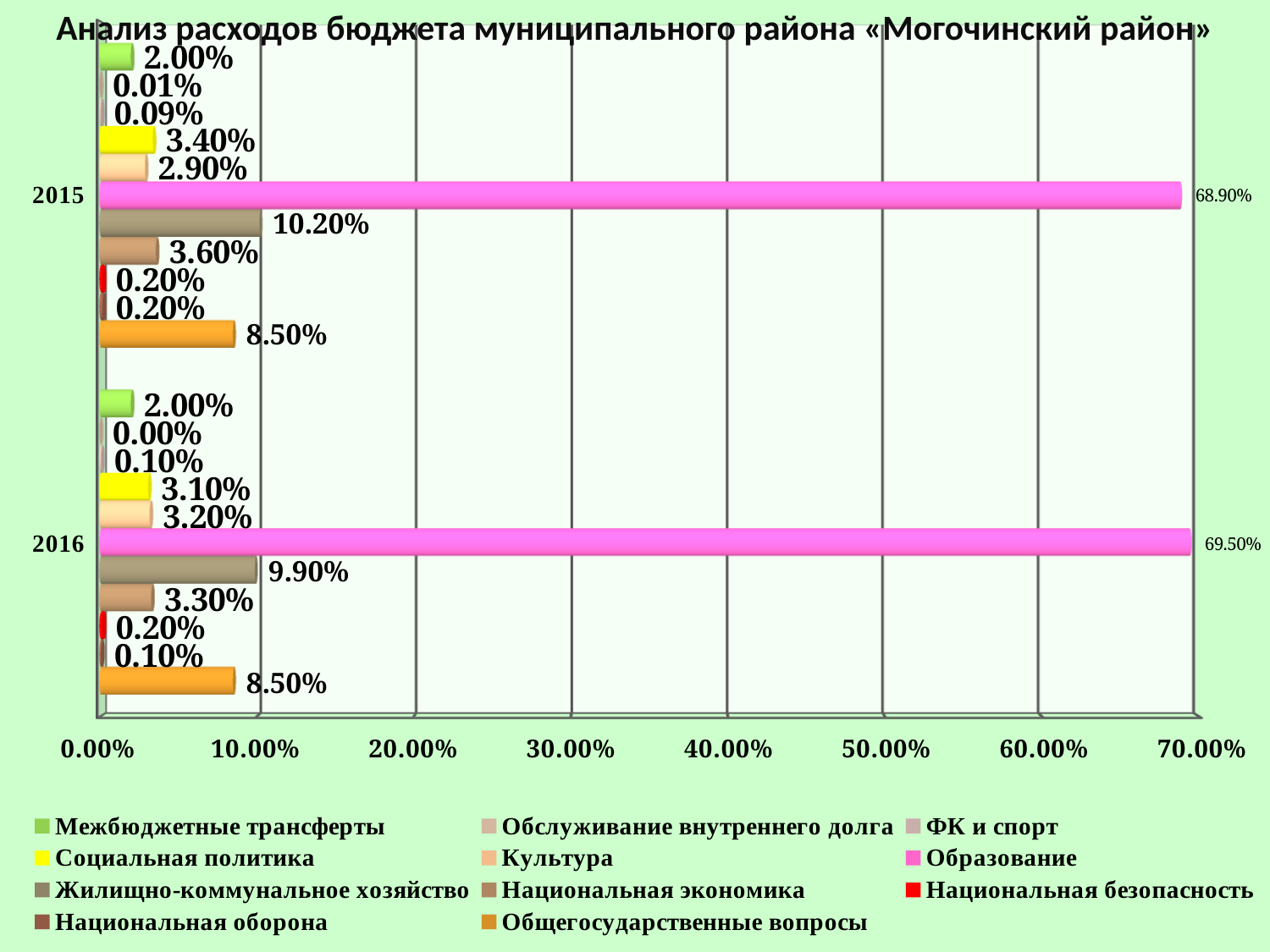
How many series does the legend list? 11 What kind of chart is shown on the slide? bar chart What is the value for Социальная политика in 2016? 3.10% Which is larger in 2015: Жилищно-коммунальное хозяйство or Общегосударственные вопросы? Жилищно-коммунальное хозяйство What is the value for Жилищно-коммунальное хозяйство in 2016? 9.90% What colour are the Образование bars? pink How many year categories are shown on the vertical axis? 2 What is the value for Общегосударственные вопросы in 2015? 8.50% What is the value for Образование in 2015? 68.90% Which series has the highest value in 2016? Образование What is the difference between the Образование values for 2016 and 2015? 0.60% What is the value for Образование in 2016? 69.50%